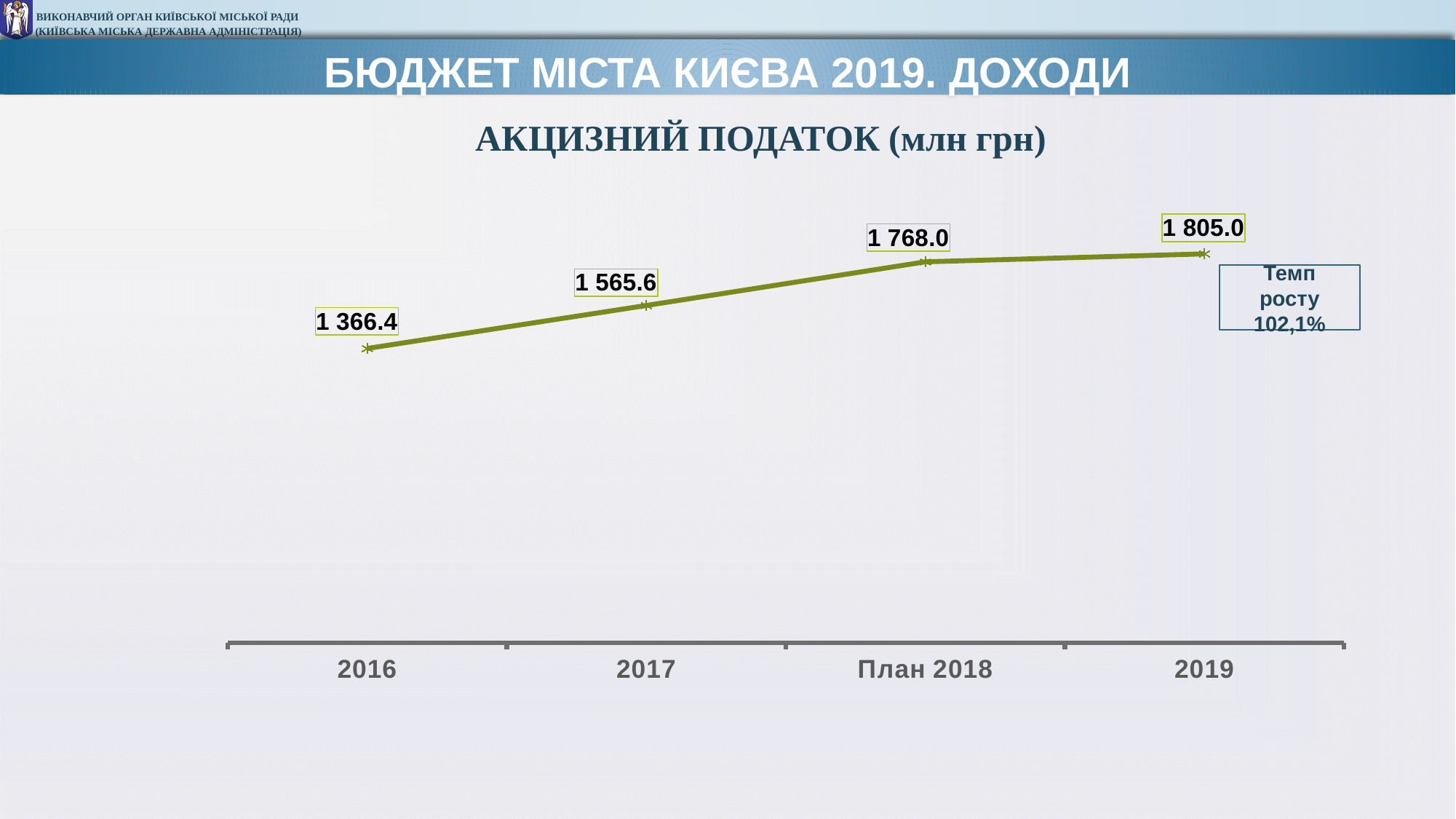
Which year has the lowest value? 2016 What is the value for 2016? 1 366.4 What kind of chart is shown? line chart What is the difference between the values for 2019 and План 2018? 37.0 Which year has the highest value? 2019 What is the value for 2017? 1 565.6 How many data points are plotted on the chart? 4 What is the difference between the values for 2017 and 2016? 199.2 What is the value for 2019? 1 805.0 What is the value for План 2018? 1 768.0 Which is larger, the value for 2017 or the value for План 2018? План 2018 Do the values rise or fall from 2016 to 2019? rise